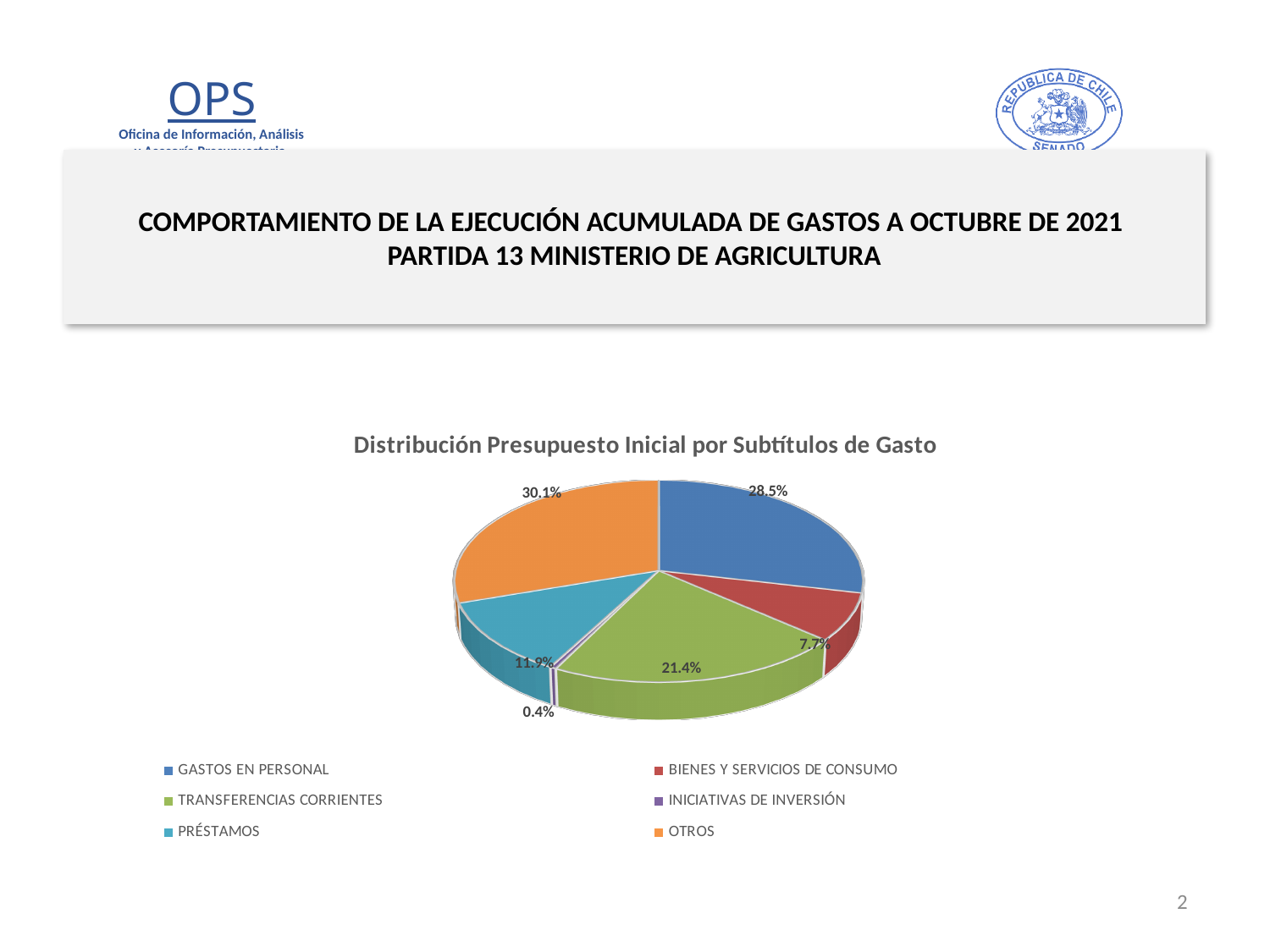
What share of the pie does TRANSFERENCIAS CORRIENTES represent? 21.4% What share of the pie does BIENES Y SERVICIOS DE CONSUMO represent? 7.7% What is the difference in percentage points between GASTOS EN PERSONAL and TRANSFERENCIAS CORRIENTES? 7.1 Which category has the largest share of the pie? OTROS What share of the pie does GASTOS EN PERSONAL represent? 28.5% Which is larger, the share for PRÉSTAMOS or the share for BIENES Y SERVICIOS DE CONSUMO? PRÉSTAMOS How many categories does the legend list? 6 What is the title of the chart? Distribución Presupuesto Inicial por Subtítulos de Gasto What kind of chart is shown on the slide? Pie chart Which category has the smallest share of the pie? INICIATIVAS DE INVERSIÓN